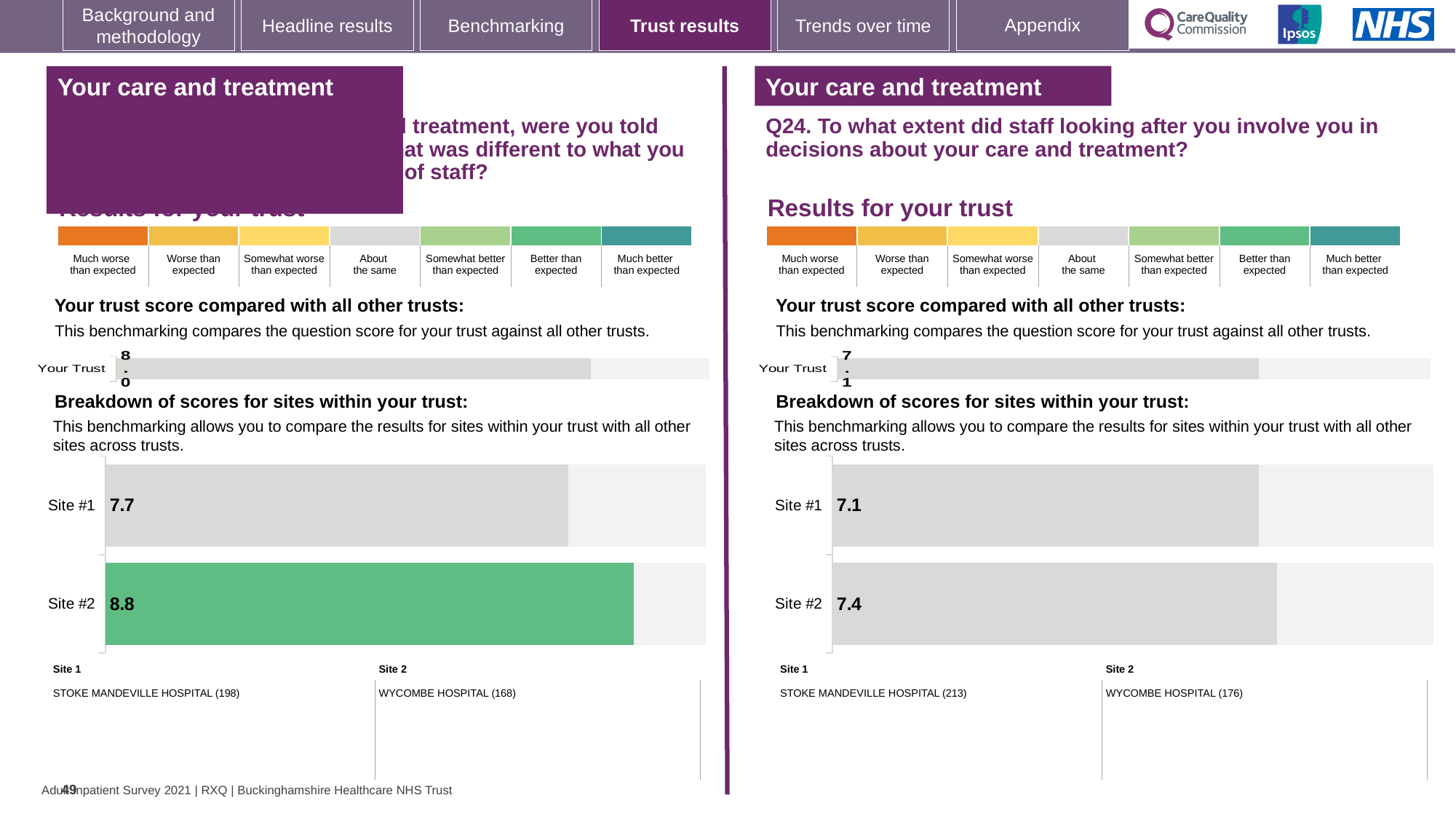
How many sites are shown in the site breakdown chart in the right-hand panel (Q24)? 2 In the left-hand panel's 'Your Trust' bar, what is the trust score shown? 8.0 What type of chart is used for the site breakdown in the left-hand panel? Bar chart In the left-hand panel's site breakdown chart, what is the score for Site #2? 8.8 In the right-hand panel (Q24) site breakdown chart, what is the score for Site #1? 7.1 In the left-hand panel's site breakdown chart, which site has the higher score? Site #2 In the left-hand panel's site breakdown chart, what is the difference between the Site #2 and Site #1 scores? 1.1 In the right-hand panel (Q24) 'Your Trust' bar, what is the trust score shown? 7.1 In the left-hand panel's site breakdown chart, what is the score for Site #1? 7.7 In the right-hand panel (Q24) site breakdown chart, which site has the lower score? Site #1 In the right-hand panel (Q24) site breakdown chart, what is the score for Site #2? 7.4 In the right-hand panel (Q24) site breakdown chart, what is the difference between the Site #2 and Site #1 scores? 0.3